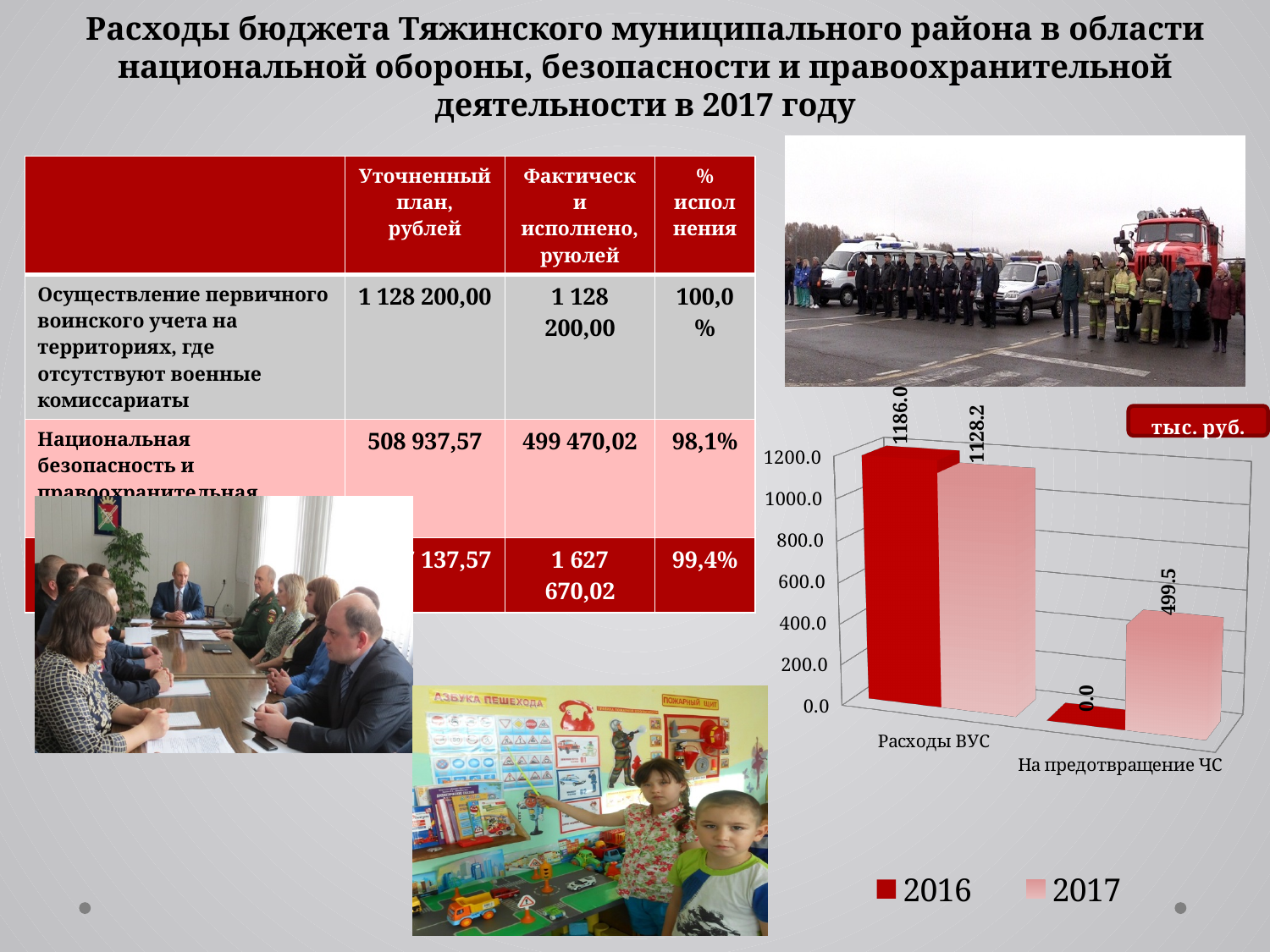
What is the value for 2016 in the "Расходы ВУС" category? 1186.0 What unit label is shown in the box at the top right of the chart? тыс. руб. What is the value for 2016 in the "На предотвращение ЧС" category? 0.0 How many series does the chart legend list? 2 What kind of chart is shown on the slide? Bar chart How many categories are shown on the x axis of the chart? 2 Which category has the lowest value for the 2017 series? На предотвращение ЧС What is the difference between the 2016 and 2017 values in the "Расходы ВУС" category? 57.8 Which series has the higher value in the "Расходы ВУС" category, 2016 or 2017? 2016 What is the difference between the 2017 values for "Расходы ВУС" and "На предотвращение ЧС"? 628.7 What is the value for 2017 in the "На предотвращение ЧС" category? 499.5 What is the value for 2017 in the "Расходы ВУС" category? 1128.2